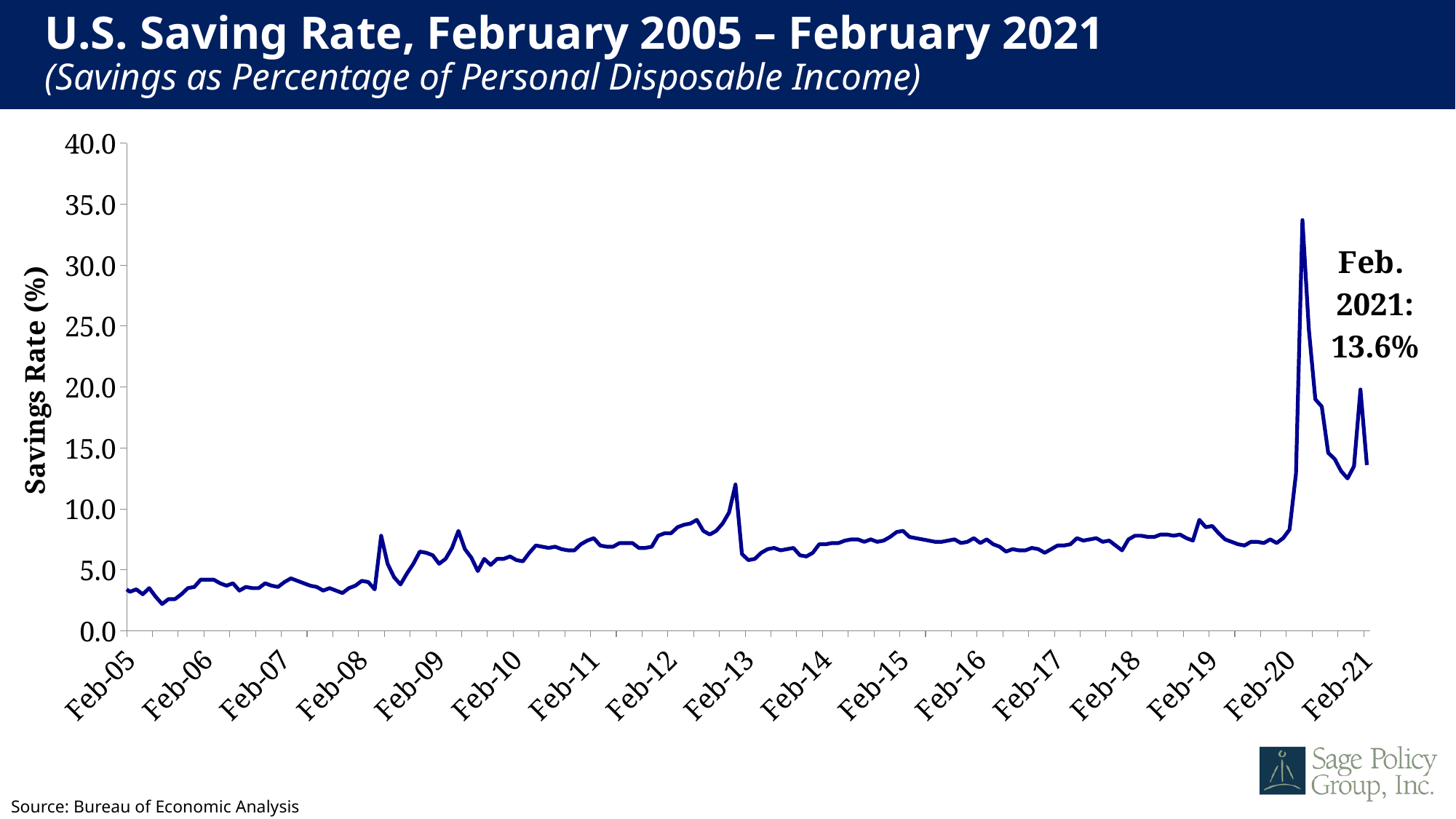
Which is larger: the saving rate at Feb-21 or the saving rate at Feb-19? Feb-21 Is the saving rate at the spike just before Feb-13 greater or less than 10? greater Is the saving rate at Feb-17 greater or less than 10? less In which year does the saving rate reach its highest point on the chart? 2020 Is the saving rate at Feb-05 greater or less than 5? less What source is cited for the chart data? Bureau of Economic Analysis What is the U.S. saving rate for February 2021 according to the data label? 13.6% What is the title of the y axis? Savings Rate (%) What kind of chart is shown on the slide? Line chart How many year labels are shown on the x axis? 17